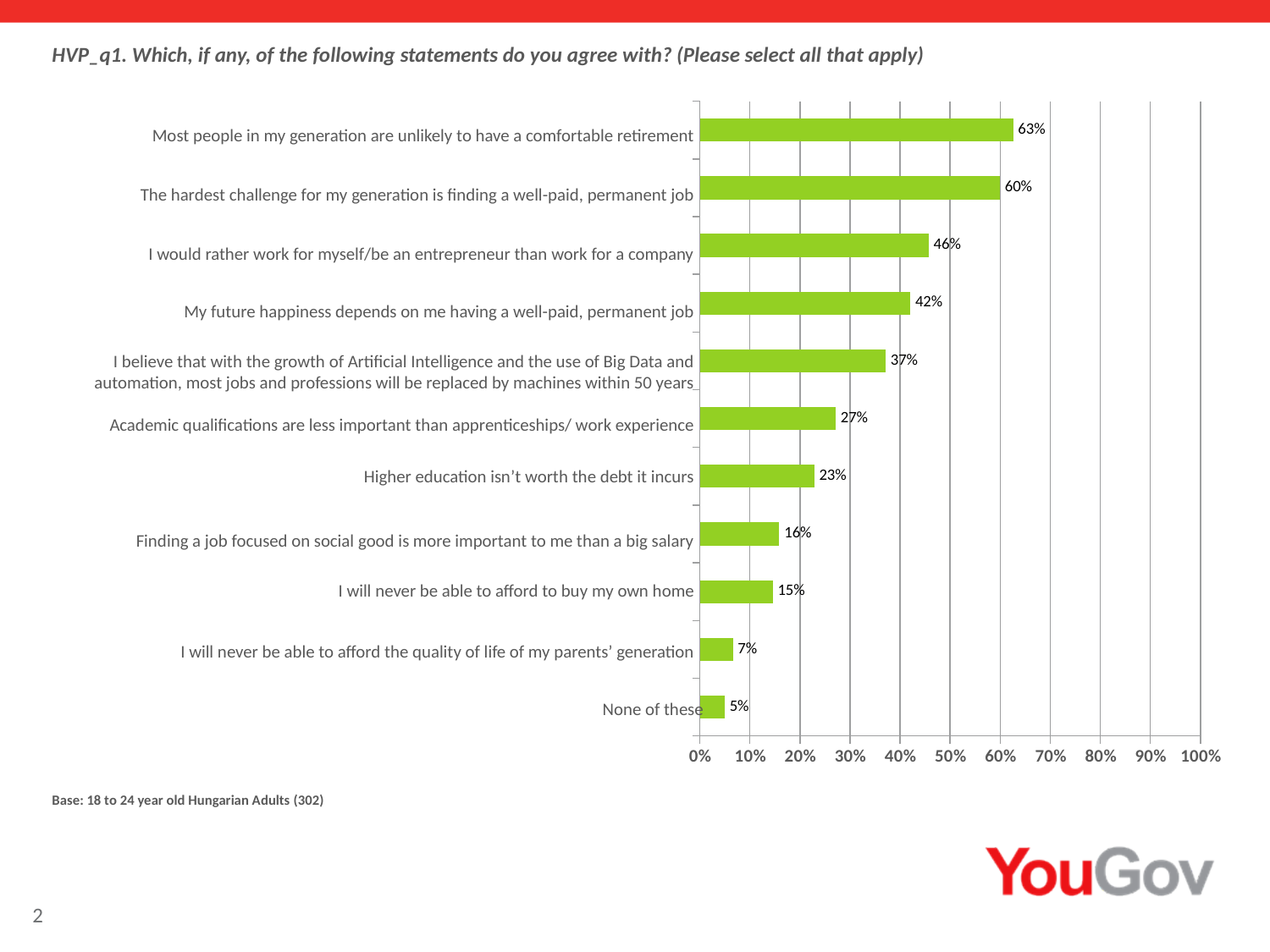
What is the maximum value shown on the horizontal axis? 100% What type of chart is shown on the slide? Bar chart What is the difference in percentage points between 'The hardest challenge for my generation is finding a well-paid, permanent job' and 'My future happiness depends on me having a well-paid, permanent job'? 18 percentage points What percentage agree that higher education isn't worth the debt it incurs? 23% Which statement has the lowest level of agreement, excluding 'None of these'? I will never be able to afford the quality of life of my parents' generation What is the base size stated for the chart? 302 Which statement has the highest level of agreement? Most people in my generation are unlikely to have a comfortable retirement What percentage selected 'None of these'? 5% Which has a higher percentage: 'I would rather work for myself/be an entrepreneur than work for a company' or 'Academic qualifications are less important than apprenticeships/ work experience'? I would rather work for myself/be an entrepreneur than work for a company Is the value for 'I believe that with the growth of Artificial Intelligence and the use of Big Data and automation, most jobs and professions will be replaced by machines within 50 years' greater or less than 40%? less How many statements (bars) are shown in the chart? 11 What percentage agree that most people in their generation are unlikely to have a comfortable retirement? 63%